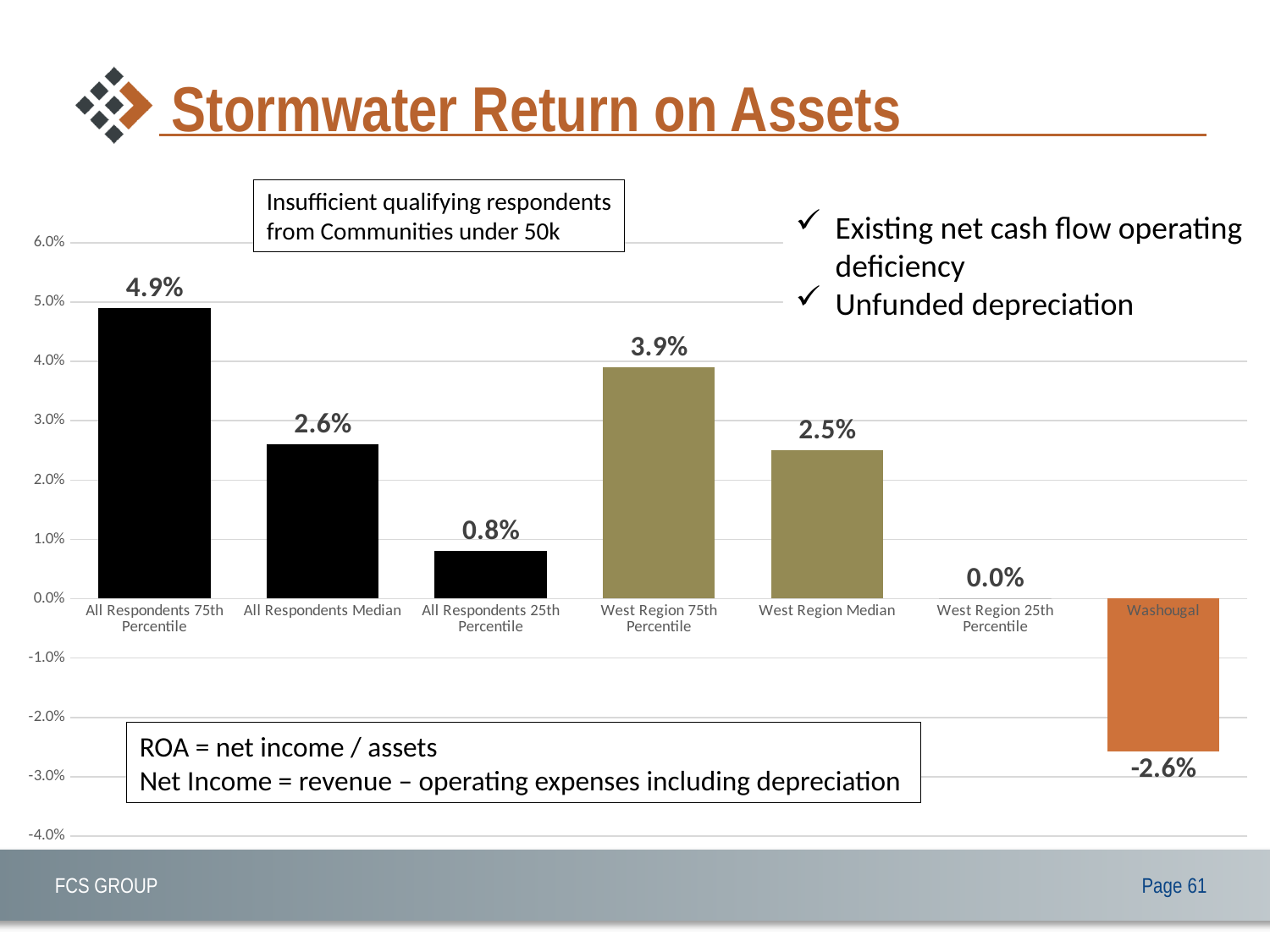
What is the value for West Region 25th Percentile? 0.0% What is the value shown for Washougal? -2.6% What is the difference between the All Respondents 75th Percentile value and the West Region 75th Percentile value? 1.0% Which category has the highest value on the chart? All Respondents 75th Percentile Which is larger, the All Respondents Median value or the West Region Median value? All Respondents Median What colour is the Washougal bar? Orange Which category has the lowest value on the chart? Washougal What kind of chart is shown on the slide? Bar chart What is the value for West Region Median? 2.5% How many categories are shown on the chart? 7 Is the value for All Respondents 25th Percentile greater or less than 1.0%? less What is the Stormwater Return on Assets value for All Respondents 75th Percentile? 4.9%